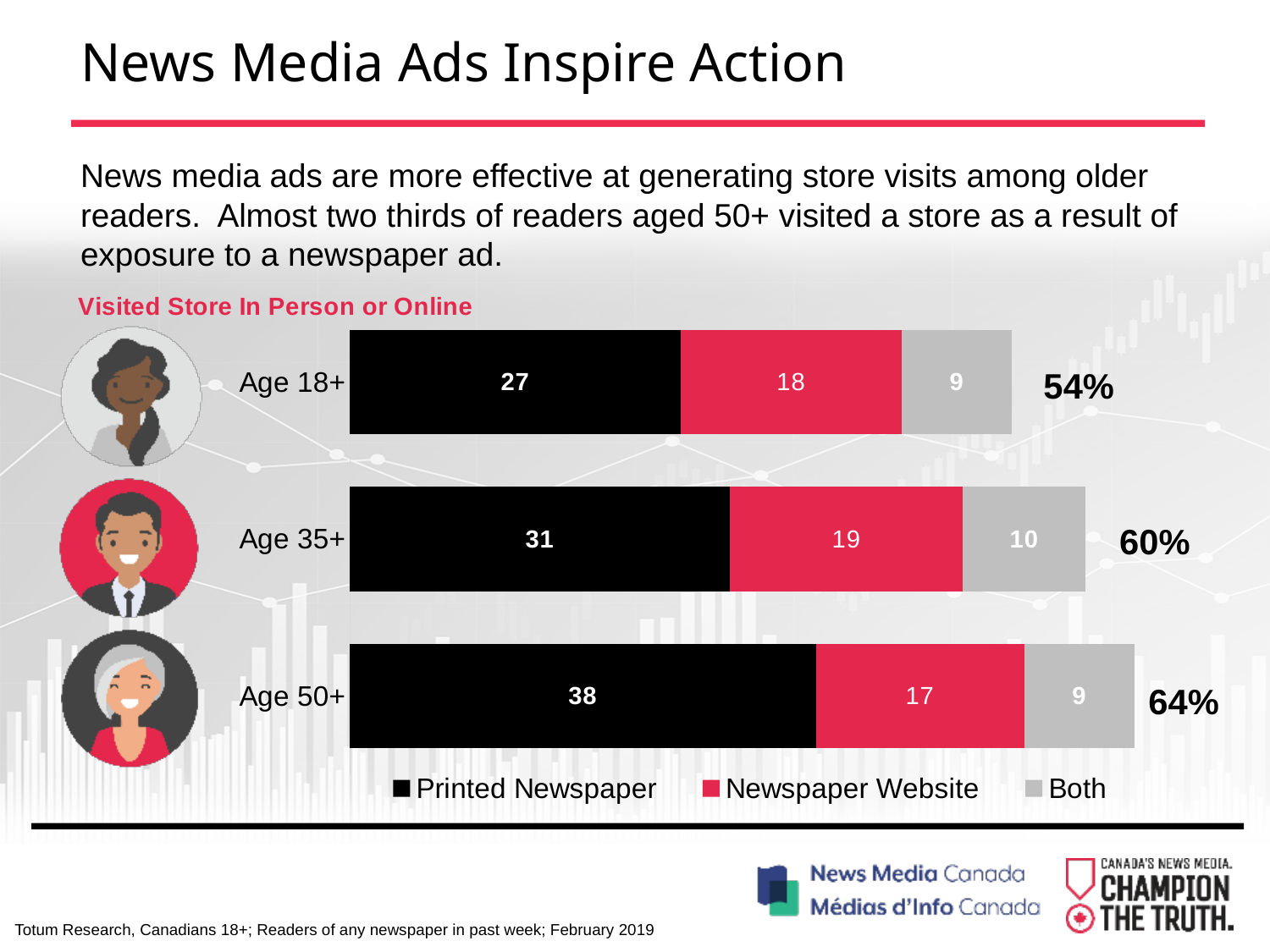
Which age group has the lowest Newspaper Website value? Age 50+ What kind of chart is shown on the slide? Stacked bar chart Which is larger, the Both value for Age 35+ or the Both value for Age 50+? Age 35+ Which age group has the highest Printed Newspaper value? Age 50+ What is the Newspaper Website value for Age 35+? 19 How many age groups are shown in the chart? 3 What is the difference between the Printed Newspaper values for Age 50+ and Age 18+? 11 What is the total shown for the Age 50+ bar? 64% What is the Printed Newspaper value for Age 50+? 38 What is the Both value for Age 18+? 9 What is the title of the chart? Visited Store In Person or Online How many series does the legend list? 3